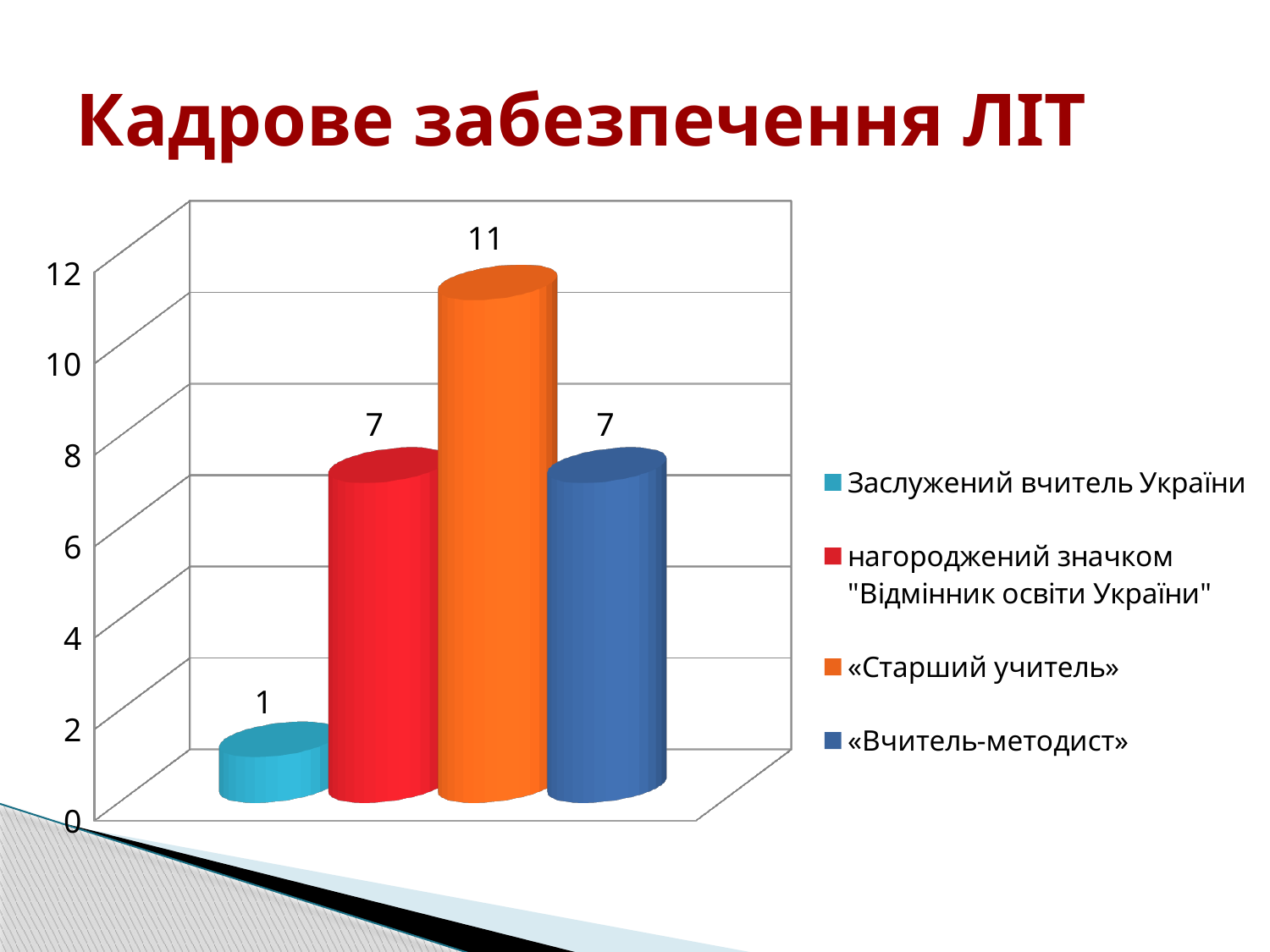
Which category has the lowest value? Заслужений вчитель України What is the value for нагороджений значком "Відмінник освіти України"? 7 What is the value for Заслужений вчитель України? 1 What is the difference between the values for «Старший учитель» and «Вчитель-методист»? 4 Is the value for «Старший учитель» greater or less than 10? greater Which category has the highest value? «Старший учитель» What is the title of the slide? Кадрове забезпечення ЛІТ Which is larger: the value for «Старший учитель» or the value for Заслужений вчитель України? «Старший учитель» What is the value for «Старший учитель»? 11 How many bars are shown in the chart? 4 What is the value for «Вчитель-методист»? 7 What kind of chart is shown on the slide? bar chart